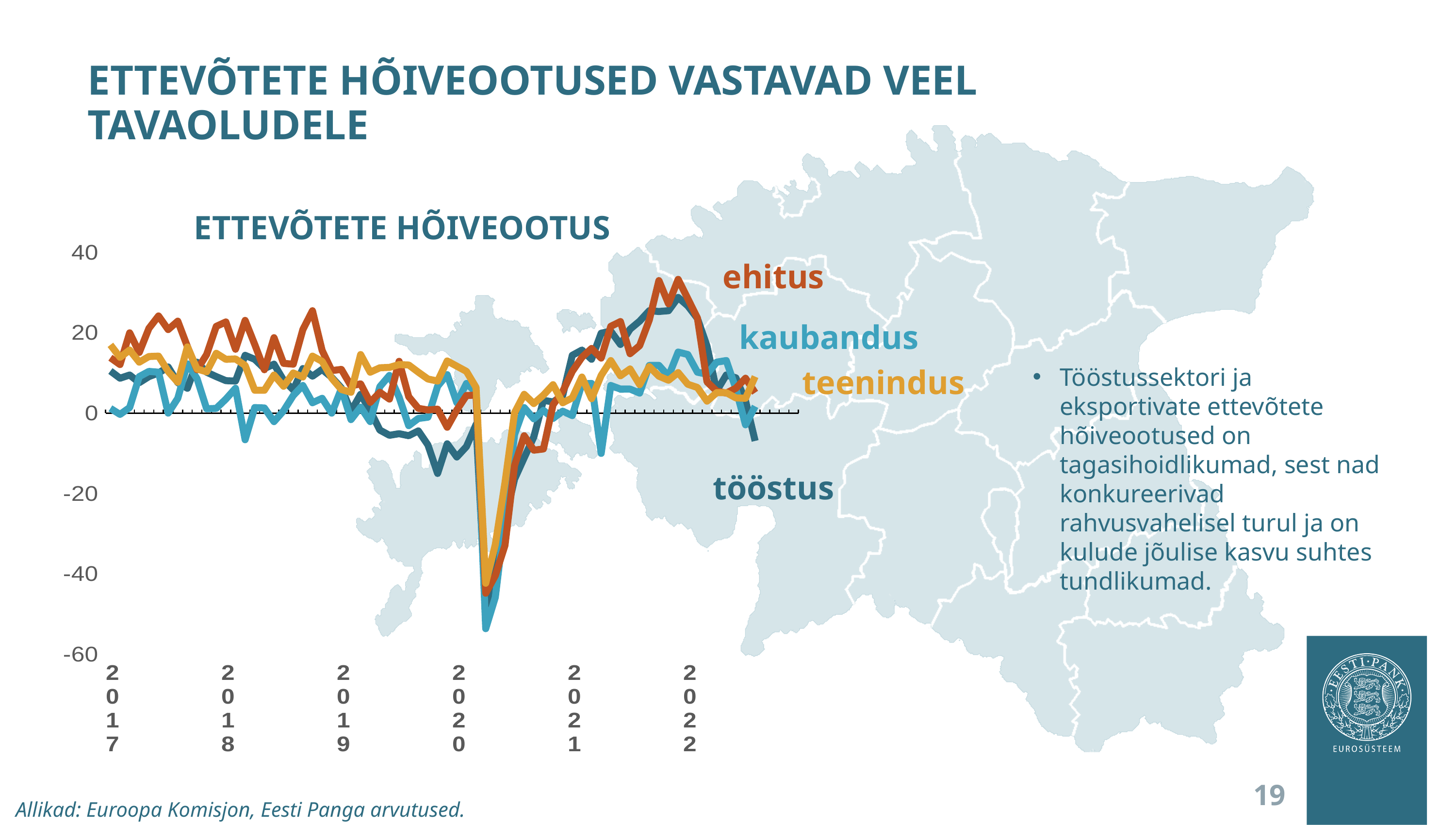
What is the title of the chart? ETTEVÕTETE HÕIVEOOTUS How many year labels are shown on the x axis? 6 Which series is drawn in the orange-red colour? ehitus Does the tööstus series rise or fall from its 2021 peak to the end of 2022? fall Is the lowest value of the teenindus series in 2020 greater or less than -20? less Is the lowest value of the kaubandus series in 2020 greater or less than -40? less Is the peak value of the ehitus series in 2021 greater or less than 20? greater How many series are labelled on the chart? 4 What kind of chart is shown on the slide? line chart Which series reaches the lowest point on the chart in 2020? kaubandus